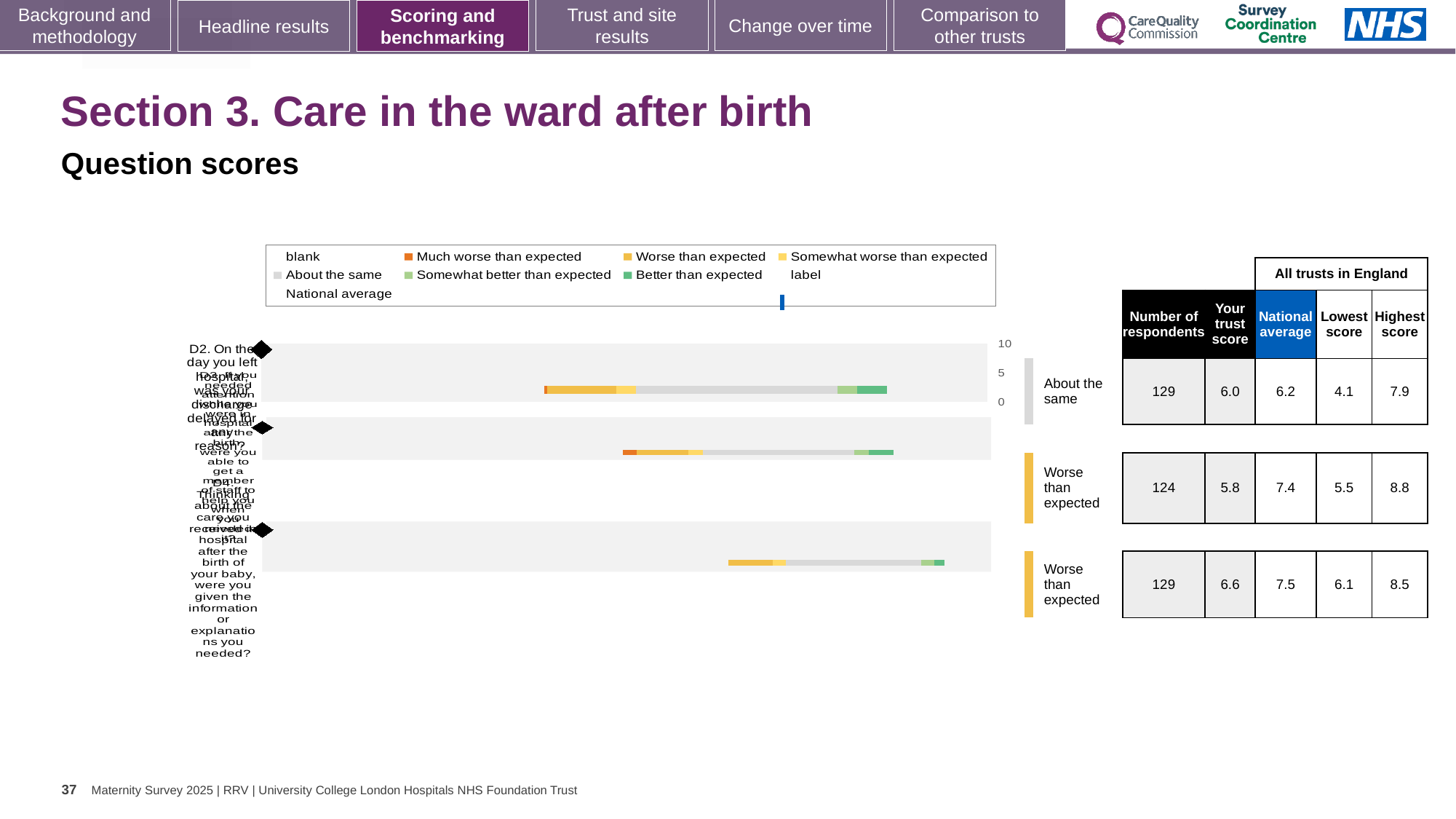
Which question row has the highest 'Your trust score'? the third (bottom) row What is the 'Your trust score' for the first (top) question row? 6.0 What is the lowest score across all trusts in England for the second question row? 5.5 For the second question row, what is the difference between the national average and the trust score? 1.6 What is the national average for the second question row? 7.4 For the first question row, which is larger: the trust score or the national average? the national average What kind of chart is shown on the slide? bar chart What benchmark category is shown next to the first question row? About the same How many respondents are listed for the second question row? 124 What is the highest score across all trusts in England for the third question row? 8.5 How many question rows are plotted in the chart? 3 Which question row has the lowest 'Your trust score'? the second (middle) row